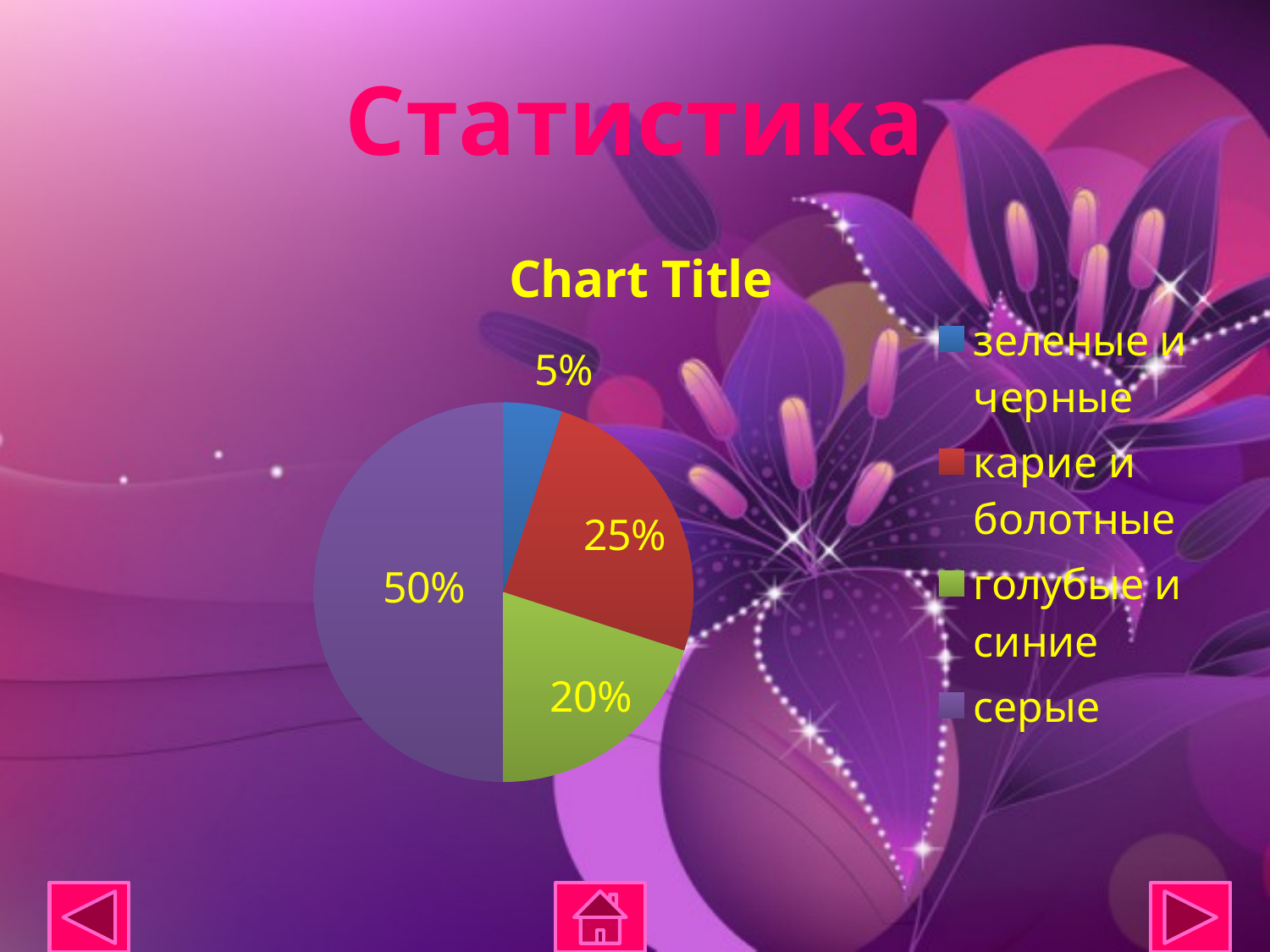
Which category has the smallest slice of the pie? зеленые и черные What is the difference between the values for серые and карие и болотные? 25% Which is larger, the value for карие и болотные or the value for голубые и синие? карие и болотные What colour is the slice for голубые и синие? green What is the value for карие и болотные? 25% Which category has the largest slice of the pie? серые What kind of chart is shown on the slide? pie chart What is the title of the chart? Chart Title What is the value for серые? 50% How many categories does the pie chart have? 4 What is the value for голубые и синие? 20% What is the value for зеленые и черные? 5%